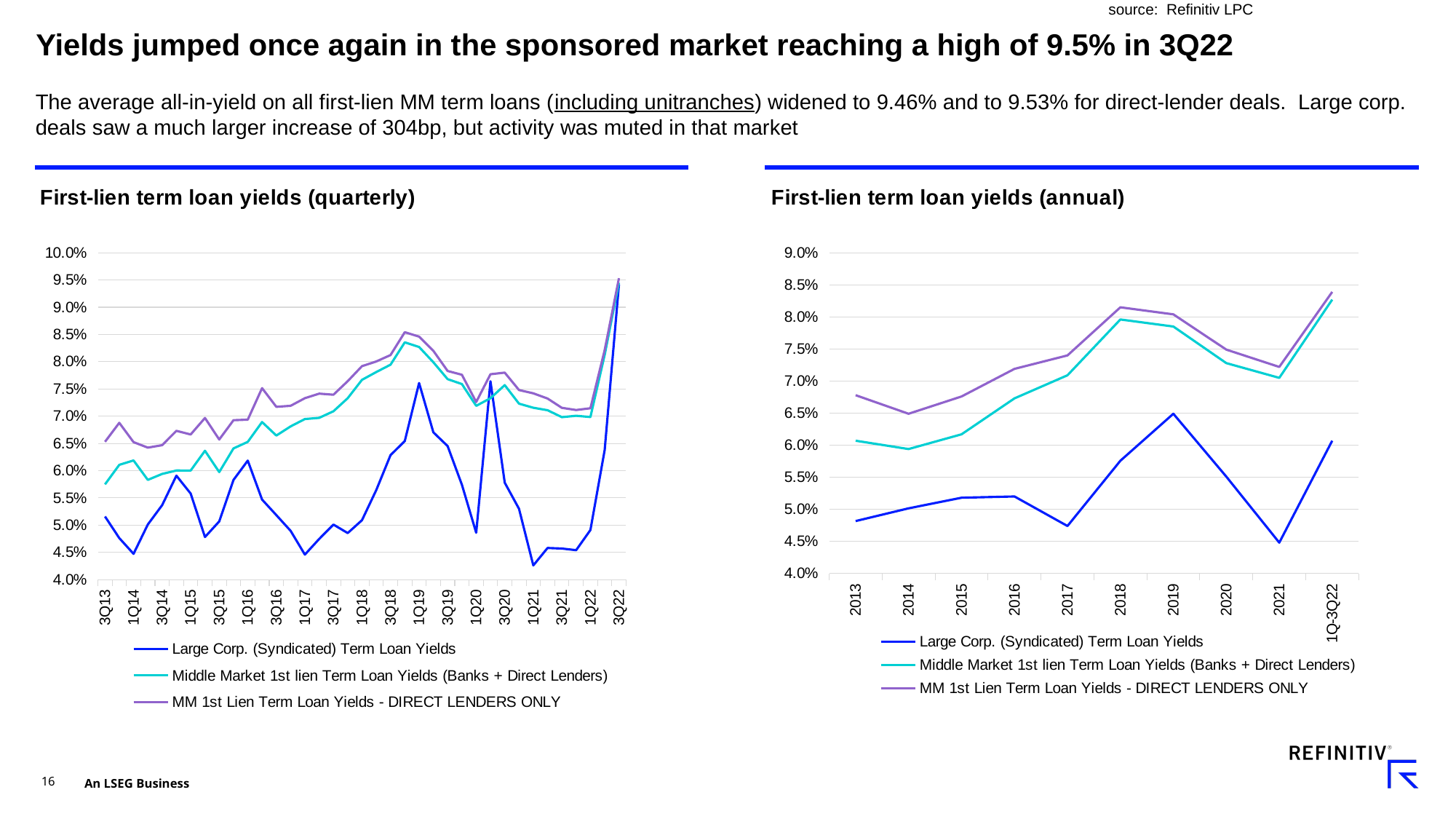
In the 'First-lien term loan yields (annual)' chart, which year has the lowest value for Large Corp. (Syndicated) Term Loan Yields? 2021 In the 'First-lien term loan yields (annual)' chart, is the value for MM 1st Lien Term Loan Yields - DIRECT LENDERS ONLY in 2018 greater or less than 8.0%? greater In the 'First-lien term loan yields (quarterly)' chart, is the value for Large Corp. (Syndicated) Term Loan Yields in 1Q21 greater or less than 4.5%? less In the 'First-lien term loan yields (annual)' chart, do the Large Corp. (Syndicated) Term Loan Yields rise or fall from 2019 to 2021? fall How many categories are shown on the x axis of the 'First-lien term loan yields (annual)' chart? 10 What colour is the line for Large Corp. (Syndicated) Term Loan Yields in the 'First-lien term loan yields (quarterly)' chart? blue In the 'First-lien term loan yields (annual)' chart, which is larger in 2019: Large Corp. (Syndicated) Term Loan Yields or Middle Market 1st lien Term Loan Yields (Banks + Direct Lenders)? Middle Market 1st lien Term Loan Yields (Banks + Direct Lenders) What kind of chart is the 'First-lien term loan yields (annual)' chart? line chart In the 'First-lien term loan yields (annual)' chart, which category has the highest value for MM 1st Lien Term Loan Yields - DIRECT LENDERS ONLY? 1Q-3Q22 How many series does the legend of the 'First-lien term loan yields (quarterly)' chart list? 3 In the 'First-lien term loan yields (quarterly)' chart, is the value for MM 1st Lien Term Loan Yields - DIRECT LENDERS ONLY in 3Q22 greater or less than 9.0%? greater